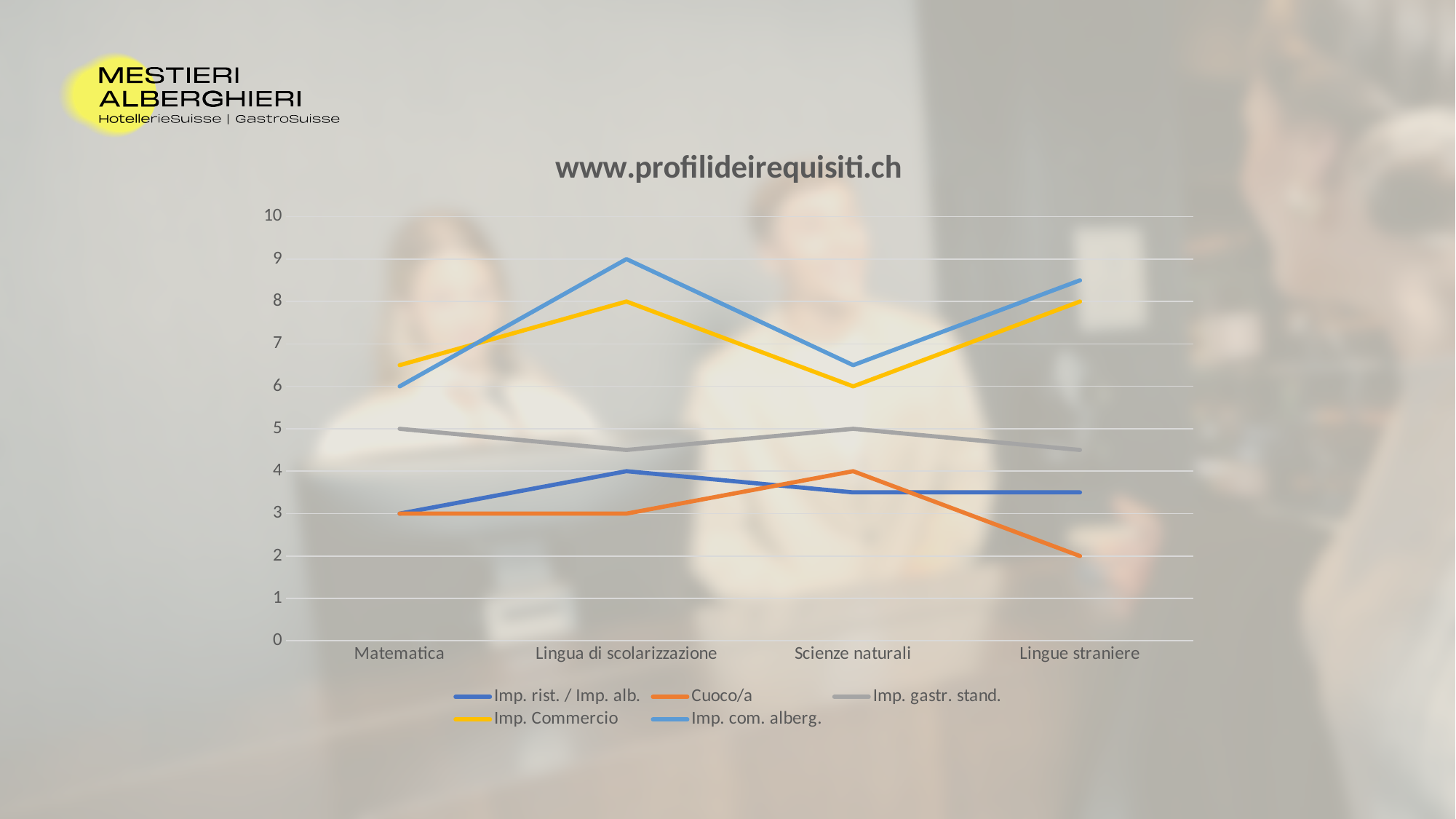
At Lingua di scolarizzazione, what is the difference between Imp. com. alberg. and Imp. Commercio? 1 What is the value for Imp. com. alberg. at Lingua di scolarizzazione? 9 Is the value for Imp. com. alberg. at Scienze naturali greater or less than 7? less What is the value for Imp. Commercio at Scienze naturali? 6 What is the value for Imp. gastr. stand. at Matematica? 5 At Lingue straniere, which is larger: Imp. rist. / Imp. alb. or Cuoco/a? Imp. rist. / Imp. alb. How many categories are shown on the x axis? 4 How many series does the legend list? 5 What kind of chart is shown on the slide? line chart For which category is the Imp. com. alberg. series highest? Lingua di scolarizzazione What is the value for Cuoco/a at Lingue straniere? 2 For which category is the Cuoco/a series lowest? Lingue straniere